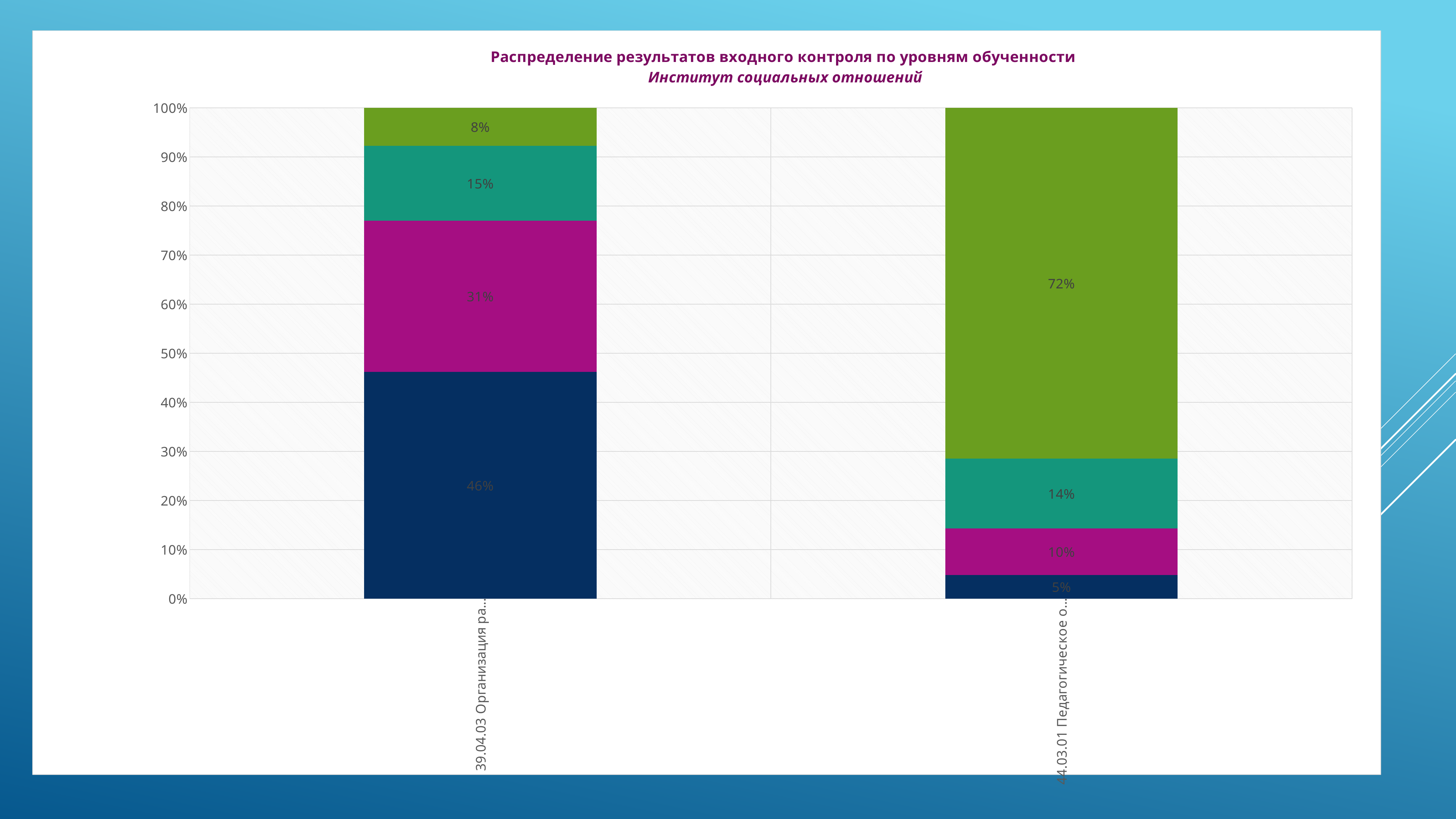
How many categories (bars) are plotted on the chart? 2 What is the value of the magenta segment for the bar labelled 39.04.03? 31% What is the total of the segments in the bar labelled 39.04.03? 100% What is the value of the dark blue (bottom) segment for the bar labelled 39.04.03? 46% What kind of chart is shown on the slide? stacked bar chart Which segment is the smallest in the bar labelled 39.04.03? the green segment (8%) What is the value of the teal segment for the bar labelled 44.03.01? 14% What is the value of the green (top) segment for the bar labelled 44.03.01? 72% What is the subtitle (second line of the title) of the chart? Институт социальных отношений What is the difference between the green segment of the 44.03.01 bar and the green segment of the 39.04.03 bar? 64% Which is larger: the dark blue segment of the 39.04.03 bar or the dark blue segment of the 44.03.01 bar? 39.04.03 (46%) Which segment is the largest in the bar labelled 44.03.01? the green segment (72%)